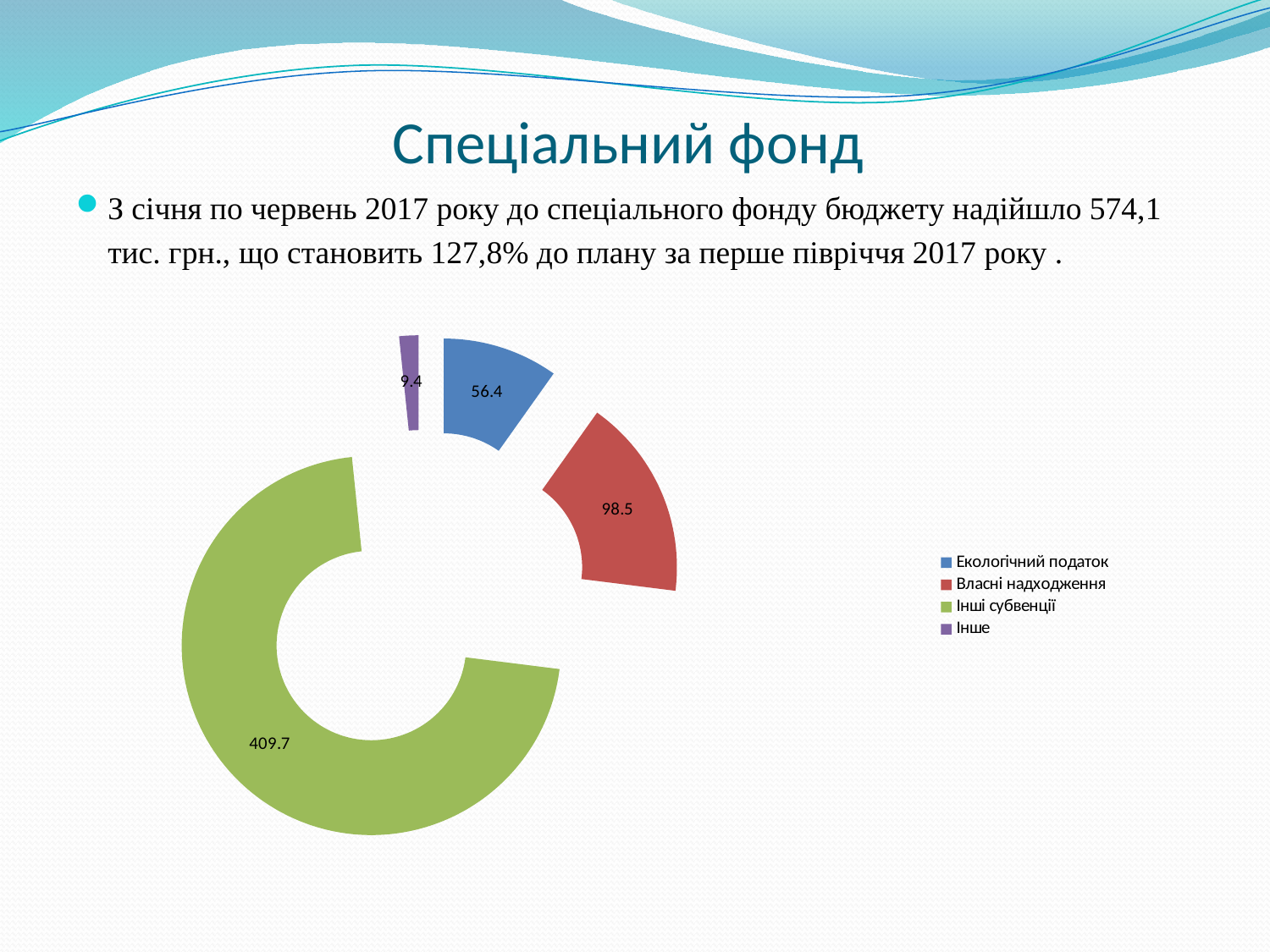
What kind of chart is shown on the slide? doughnut chart What is the value for Інше in the chart? 9.4 Which category has the largest value in the chart? Інші субвенції How many categories are shown in the chart? 4 What is the value for Власні надходження in the chart? 98.5 What is the value for Інші субвенції in the chart? 409.7 What is the difference between the values for Власні надходження and Екологічний податок? 42.1 What is the difference between the values for Інші субвенції and Власні надходження? 311.2 What is the value for Екологічний податок in the chart? 56.4 What colour is the slice for Інші субвенції? green Which category has the smallest value in the chart? Інше Which is larger, the value for Екологічний податок or the value for Інше? Екологічний податок